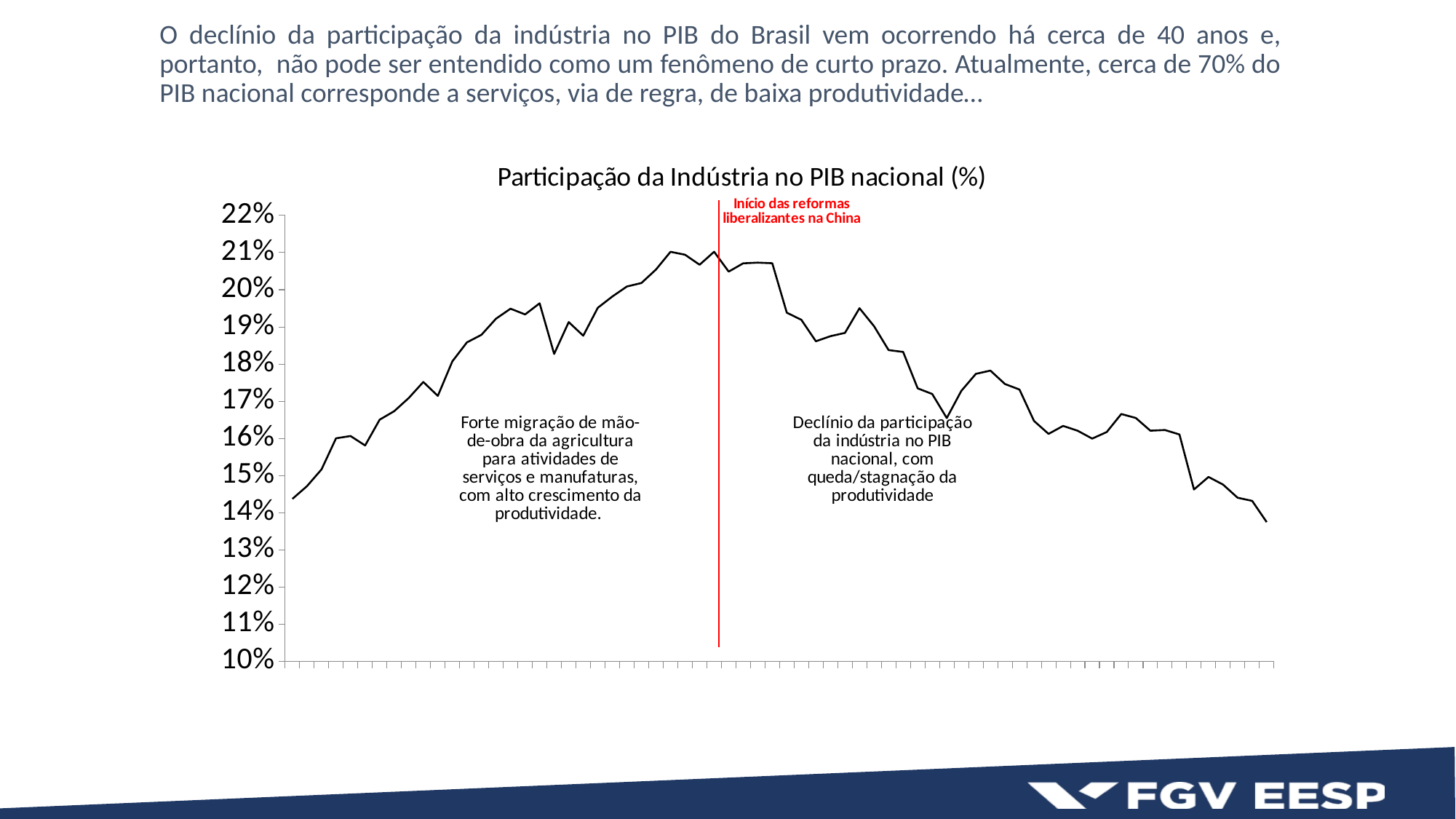
What event does the red vertical line on the chart mark? Início das reformas liberalizantes na China What is the title of the chart? Participação da Indústria no PIB nacional (%) Does the line rise or fall along the x axis to the right of the red vertical line? fall Which is larger, the value at the left end of the line or the value at the right end of the line? the value at the left end Is the value at the right end of the line greater or less than 12%? greater Is the value at the left end of the line greater or less than 16%? less Is the highest value reached by the line greater or less than 20%? greater How many data series are plotted on the chart? 1 What kind of chart is shown on the slide? line chart Does the line rise or fall along the x axis to the left of the red vertical line? rise